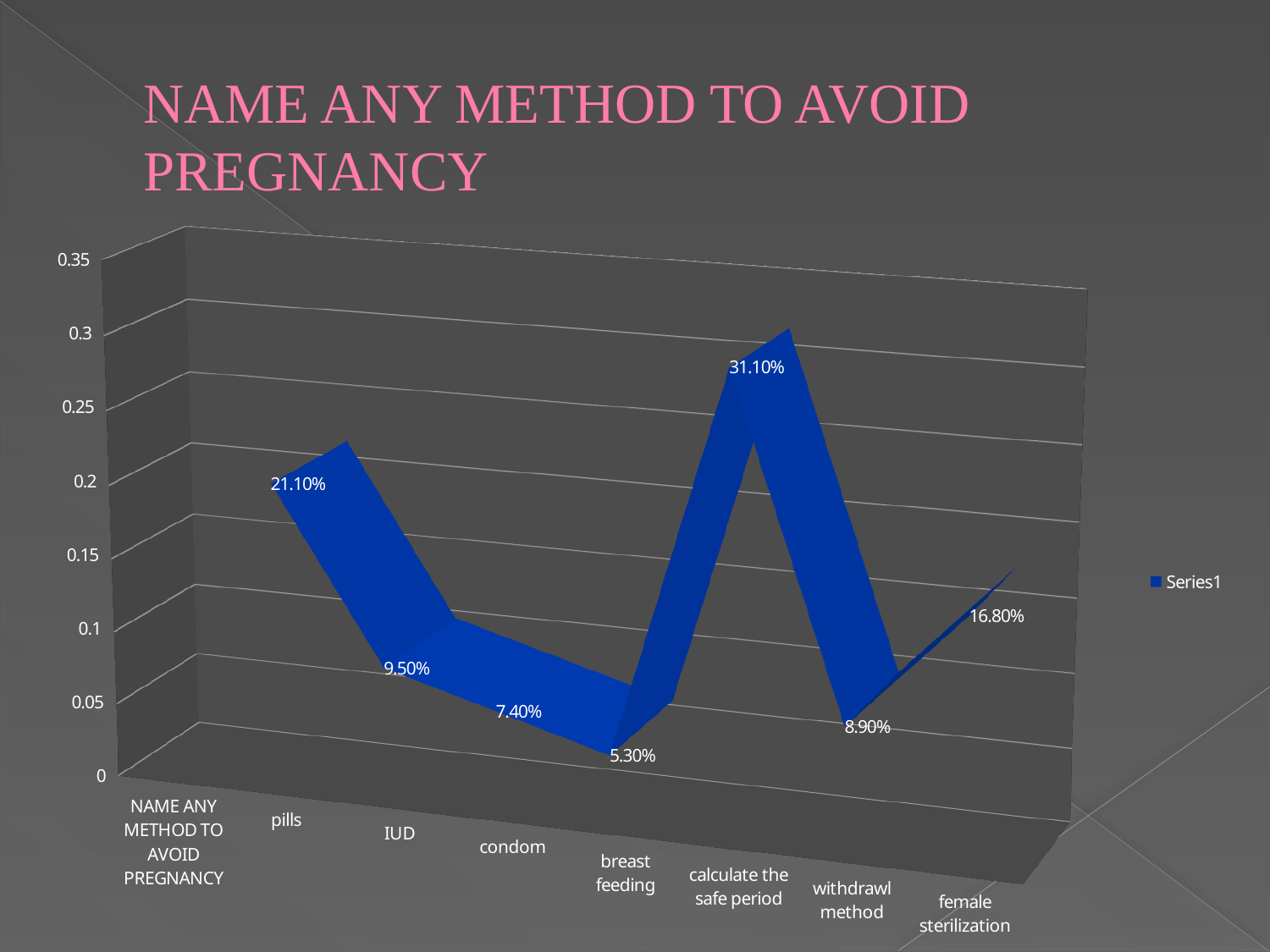
What is the value for pills? 21.10% Is the value for female sterilization greater or less than 0.1 on the axis? greater What kind of chart is shown on the slide? line chart What is the difference between the values for pills and IUD? 11.60% Which method has the highest value? calculate the safe period Which method has the lowest value? breast feeding Which is larger, the value for withdrawl method or the value for condom? withdrawl method How many series does the legend list? 1 What is the value for female sterilization? 16.80% What is the value for calculate the safe period? 31.10% What is the value for breast feeding? 5.30% What is the name of the series shown in the legend? Series1